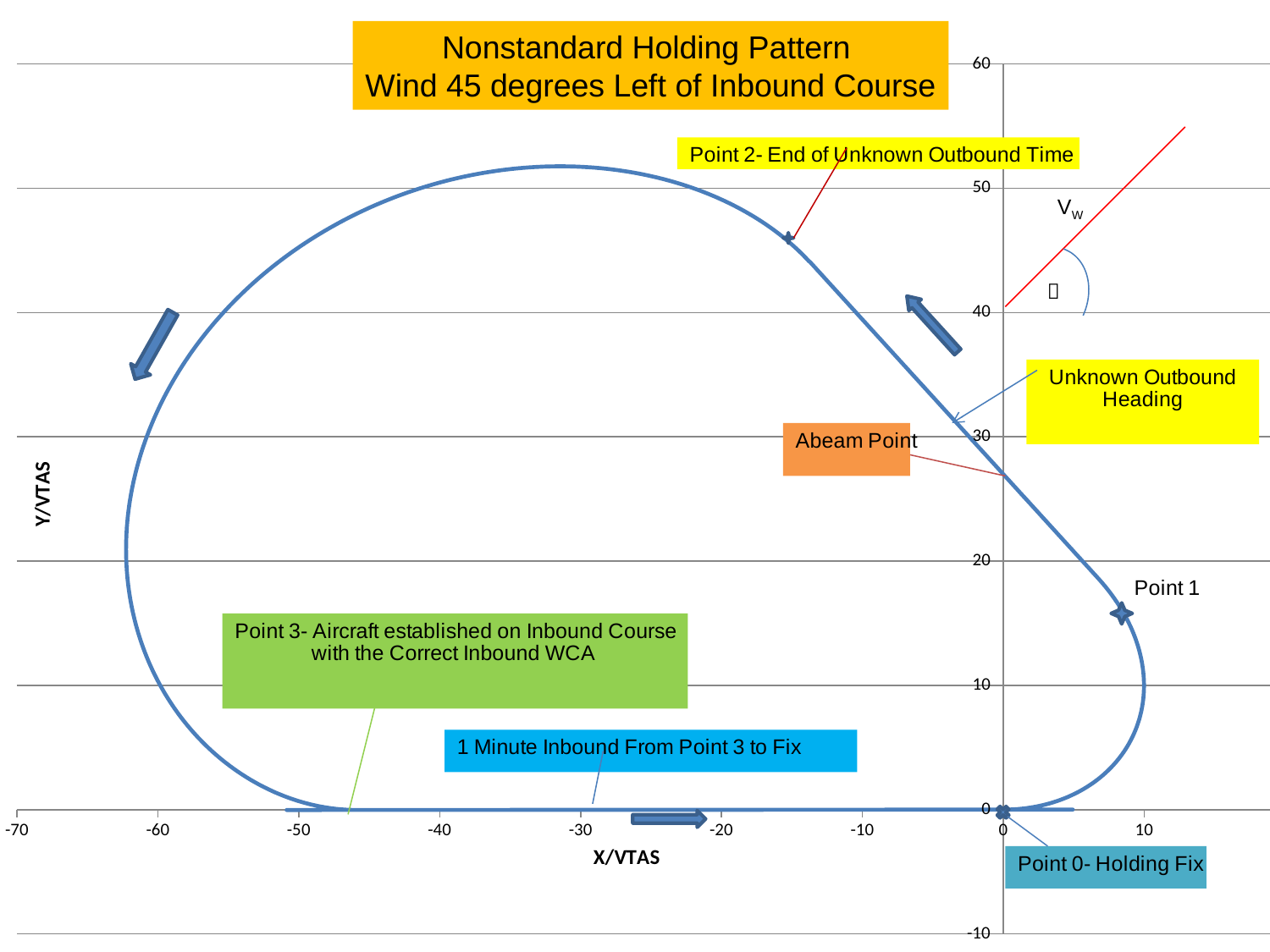
What is the Y/VTAS value at Point 3, where the aircraft is established on the inbound course? 0 Is the Y/VTAS value at the Abeam Point greater or less than 20? greater What is the title of the chart? Nonstandard Holding Pattern Wind 45 degrees Left of Inbound Course What is the Y/VTAS value of Point 0 - Holding Fix? 0 What is the X/VTAS value of Point 0 - Holding Fix? 0 What is the label of the horizontal axis? X/VTAS Which labeled point has the higher Y/VTAS value, Point 1 or Point 2? Point 2 Is the highest Y/VTAS value reached by the holding pattern curve greater or less than 50? greater Is the Y/VTAS value at Point 2 - End of Unknown Outbound Time greater or less than 40? greater What kind of chart is shown on the slide? line chart